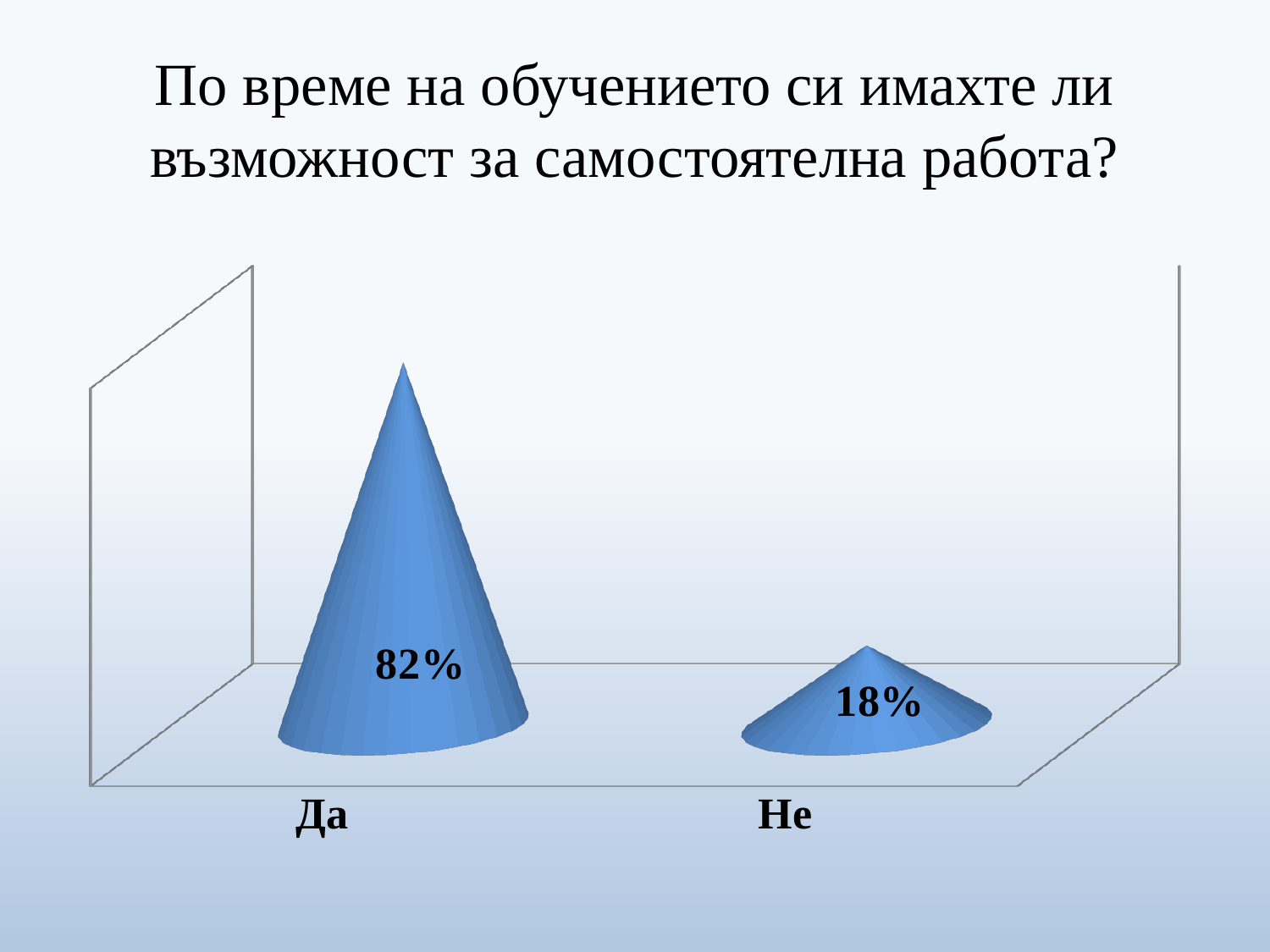
What colour are the bars on the chart? Blue What is the value for Не? 18% Which is larger, the value for Да or the value for Не? Да How many categories are shown on the chart? 2 What is the value for Да? 82% Which category has the lowest value? Не Which category has the highest value? Да What is the difference between the values for Да and Не? 64% What is the total of the two values shown on the chart? 100% What is the title of the slide containing the chart? По време на обучението си имахте ли възможност за самостоятелна работа? What kind of chart is shown on the slide? Bar chart